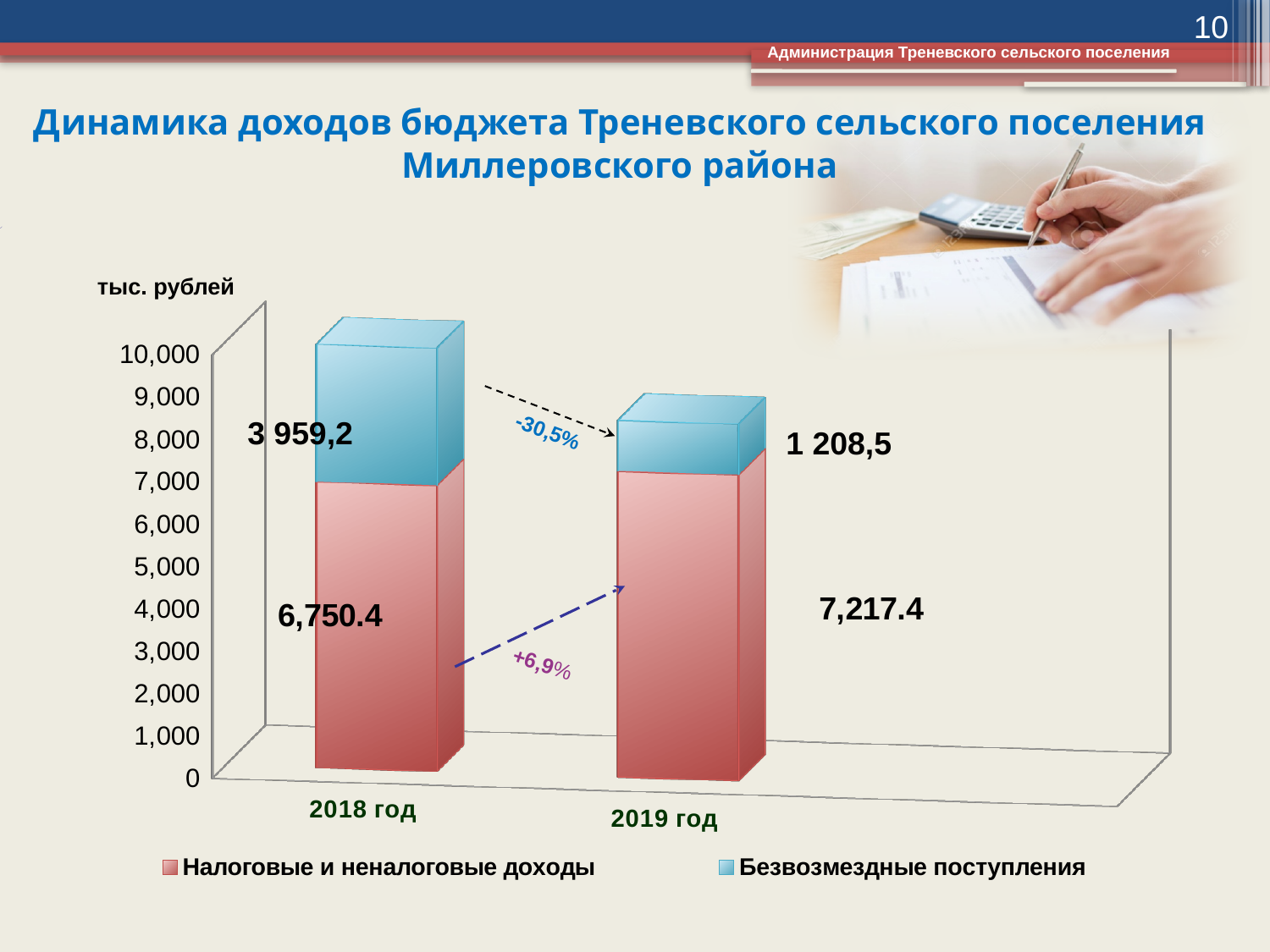
What is the value of Налоговые и неналоговые доходы for 2019 год? 7,217.4 What is the difference between Безвозмездные поступления in 2018 год and 2019 год? 2 750,7 How many series does the legend list? 2 By how much did Налоговые и неналоговые доходы increase from 2018 год to 2019 год? 467.0 What is the value of Безвозмездные поступления for 2018 год? 3 959,2 What is the value of Налоговые и неналоговые доходы for 2018 год? 6,750.4 Which year has the higher value for Безвозмездные поступления? 2018 год What unit is indicated for the values on the chart? тыс. рублей What type of chart is shown on the slide? stacked bar chart What is the value of Безвозмездные поступления for 2019 год? 1 208,5 What percentage change is shown on the arrow for Безвозмездные поступления between 2018 and 2019? -30,5% How many years (categories) are shown on the x axis? 2